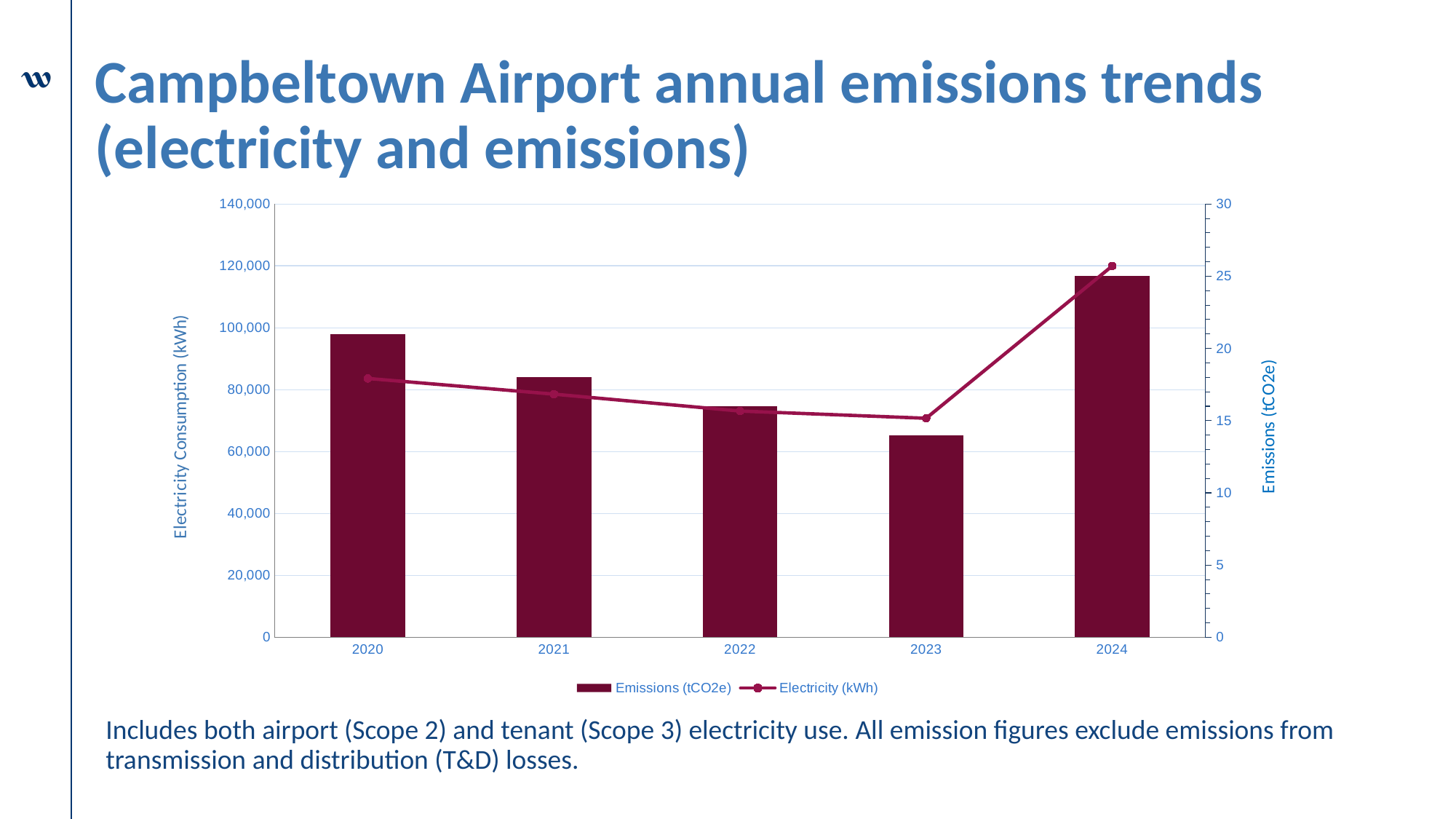
Which year has the tallest bar in the chart? 2024 How many years are shown on the x axis of the chart? 5 Which bar is taller, 2020 or 2021? 2020 Is the bar for 2023 greater or less than 80,000 on the left axis? less Which year has the shortest bar in the chart? 2023 Does the line series rise or fall from 2020 to 2023? fall Is the bar for 2020 greater or less than 80,000 on the left axis? greater What is the title of the left vertical axis of the chart? Electricity Consumption (kWh) Is the bar for 2024 greater or less than 100,000 on the left axis? greater How many series does the chart legend list? 2 What kind of chart is shown on the slide? A combined bar and line chart